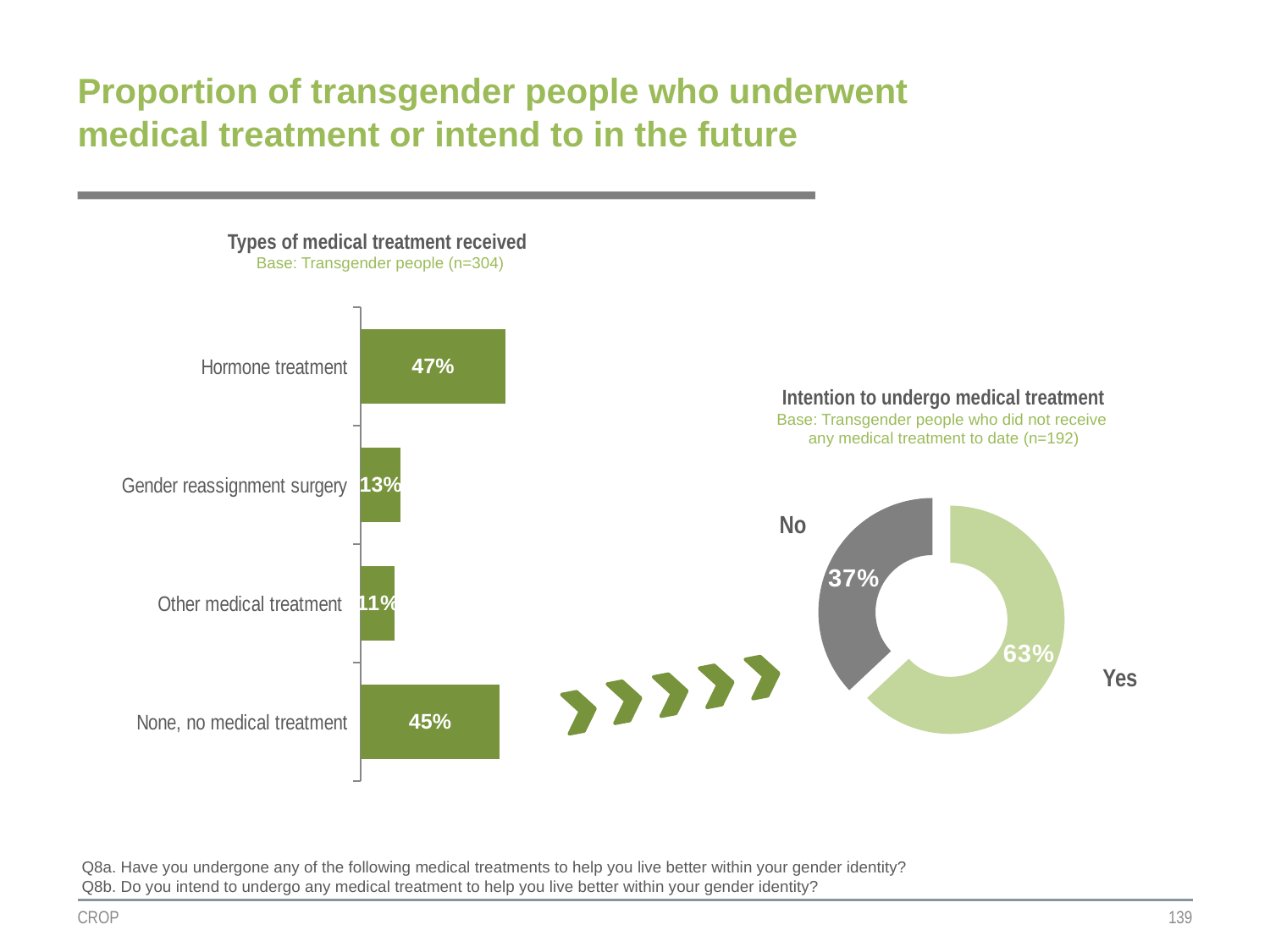
In the 'Types of medical treatment received' chart, how many categories are shown? 4 In the 'Types of medical treatment received' chart, what is the difference between hormone treatment and gender reassignment surgery? 34 percentage points In the 'Types of medical treatment received' chart, what percentage received no medical treatment? 45% In the 'Types of medical treatment received' chart, which category has the highest value? Hormone treatment In the 'Intention to undergo medical treatment' chart, what share answered Yes? 63% In the 'Types of medical treatment received' chart, what percentage received hormone treatment? 47% What kind of chart is 'Types of medical treatment received'? Bar chart In the 'Intention to undergo medical treatment' chart, what share answered No? 37% In the 'Intention to undergo medical treatment' chart, what is the base size (n) stated below the title? n=192 In the 'Types of medical treatment received' chart, what percentage had gender reassignment surgery? 13% In the 'Types of medical treatment received' chart, what percentage received other medical treatment? 11% In the 'Types of medical treatment received' chart, which category has the lowest value? Other medical treatment